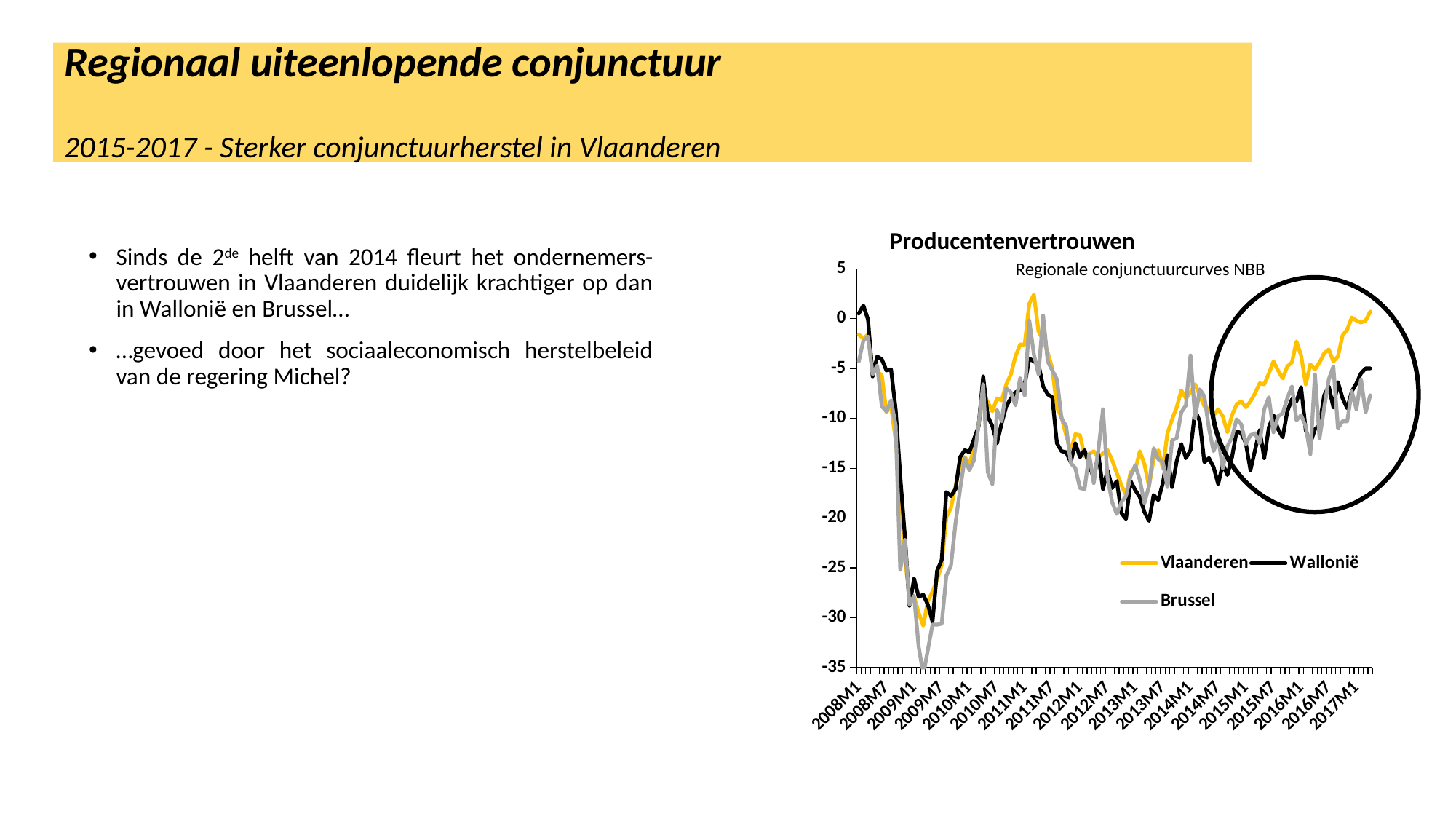
What kind of chart is shown on the slide? line chart Is the lowest value reached by the Brussel series greater or less than -30? less What is the title of the chart? Producentenvertrouwen At 2016M1, which series is higher: Vlaanderen or Brussel? Vlaanderen Which series reaches the lowest value on the chart? Brussel Does the Vlaanderen series rise or fall between 2015M1 and 2017M1? rise At 2017M1, which series is higher: Vlaanderen or Wallonië? Vlaanderen How many labels are shown on the x axis of the chart? 19 Is the value for Wallonië at 2013M1 greater or less than -15? less Is the value for Vlaanderen at 2017M1 greater or less than -5? greater How many series does the legend of the chart list? 3 Which colour is used for the Vlaanderen series? yellow